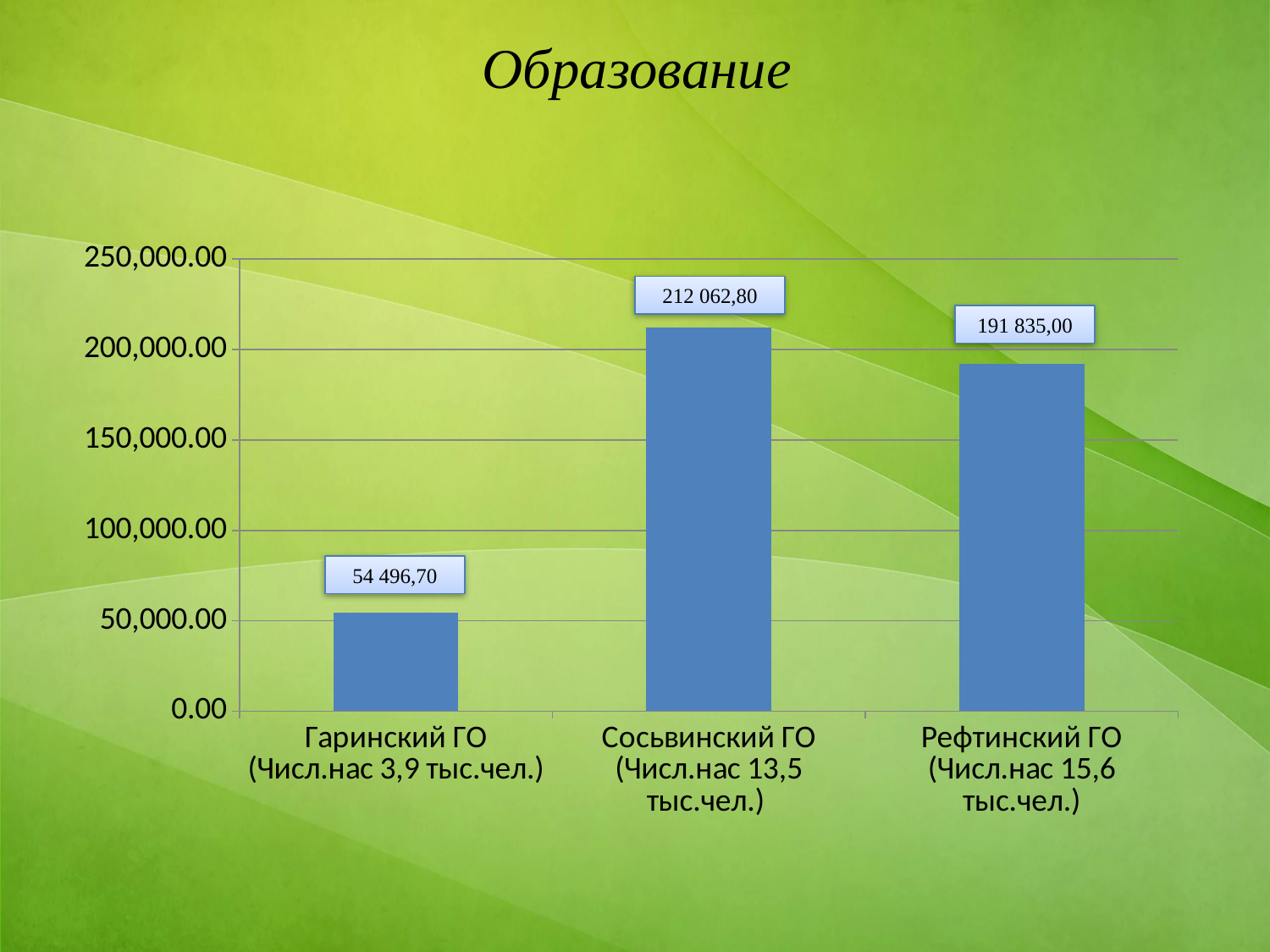
Which category has the lowest value? Гаринский ГО Is the value for Рефтинский ГО greater or less than 200,000.00? less What is the value for Рефтинский ГО? 191 835,00 Which is larger, the value for Рефтинский ГО or the value for Гаринский ГО? Рефтинский ГО What is the value for Сосьвинский ГО? 212 062,80 What is the title of the slide? Образование What kind of chart is shown on the slide? bar chart What is the value for Гаринский ГО? 54 496,70 What is the difference between the values for Сосьвинский ГО and Рефтинский ГО? 20 227,80 What is the difference between the values for Рефтинский ГО and Гаринский ГО? 137 338,30 Which category has the highest value? Сосьвинский ГО How many categories are shown in the chart? 3